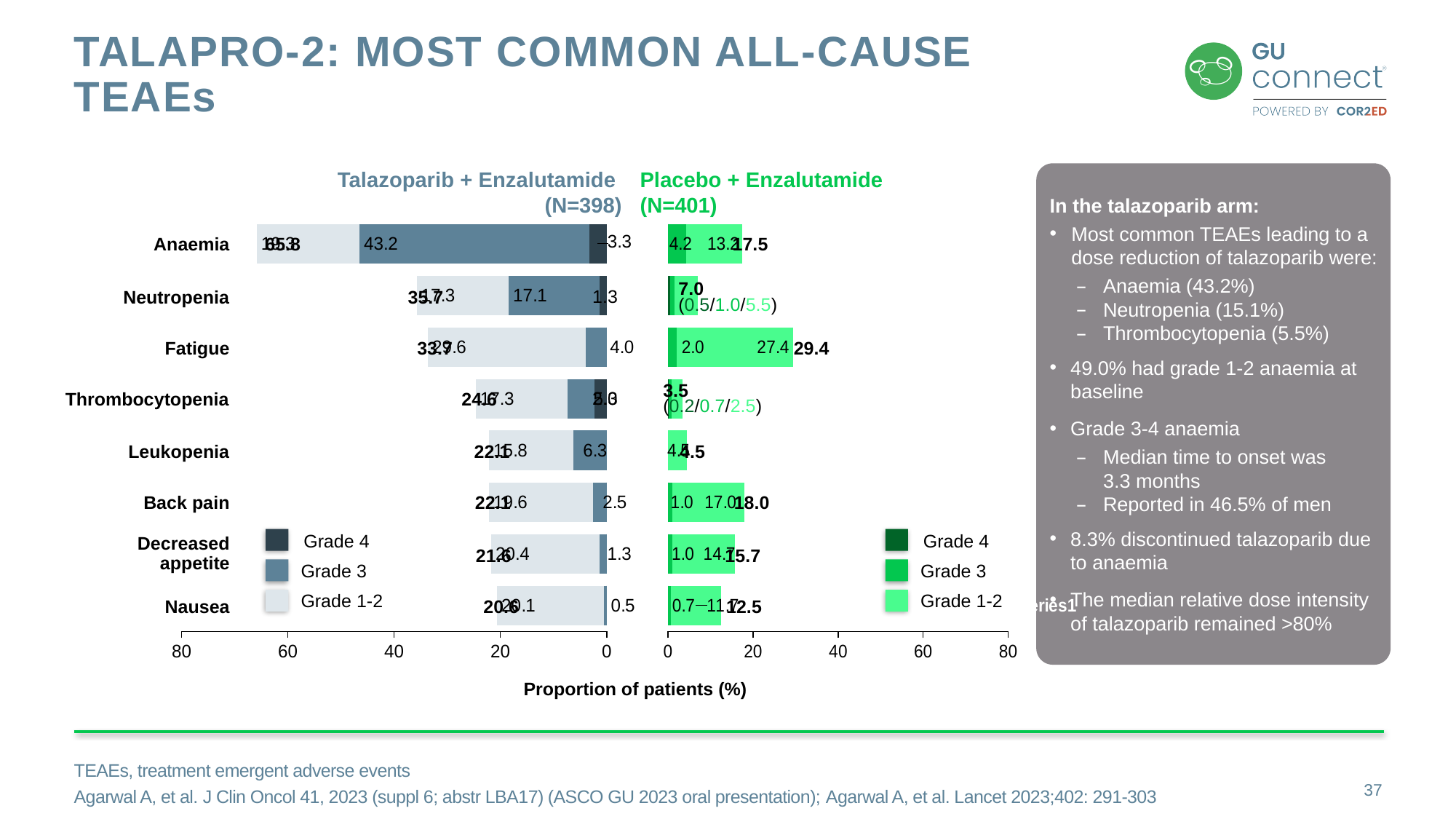
In the Placebo + Enzalutamide chart, what is the Grade 3 value for Anaemia? 4.2 What is the title of the x axis of the chart? Proportion of patients (%) What kind of chart is used on this slide to show the TEAEs? Bar chart In the Talazoparib + Enzalutamide chart, what is the Grade 3 value for Anaemia? 43.2 In the Talazoparib + Enzalutamide chart, which has the larger Grade 3 value: Neutropenia or Leukopenia? Neutropenia How many adverse event categories are listed on the y axis of the chart? 8 In the Placebo + Enzalutamide chart, which adverse event has the highest total proportion of patients? Fatigue In the Talazoparib + Enzalutamide chart, is the total bar for Anaemia greater or less than 60? greater In the Placebo + Enzalutamide chart, what is the total proportion of patients with Back pain? 18.0 In the Placebo + Enzalutamide chart, what is the total proportion of patients with Fatigue? 29.4 In the Placebo + Enzalutamide chart, what is the difference between the total for Fatigue and the total for Anaemia? 11.9 How many series does the legend of the Talazoparib + Enzalutamide chart list? 3